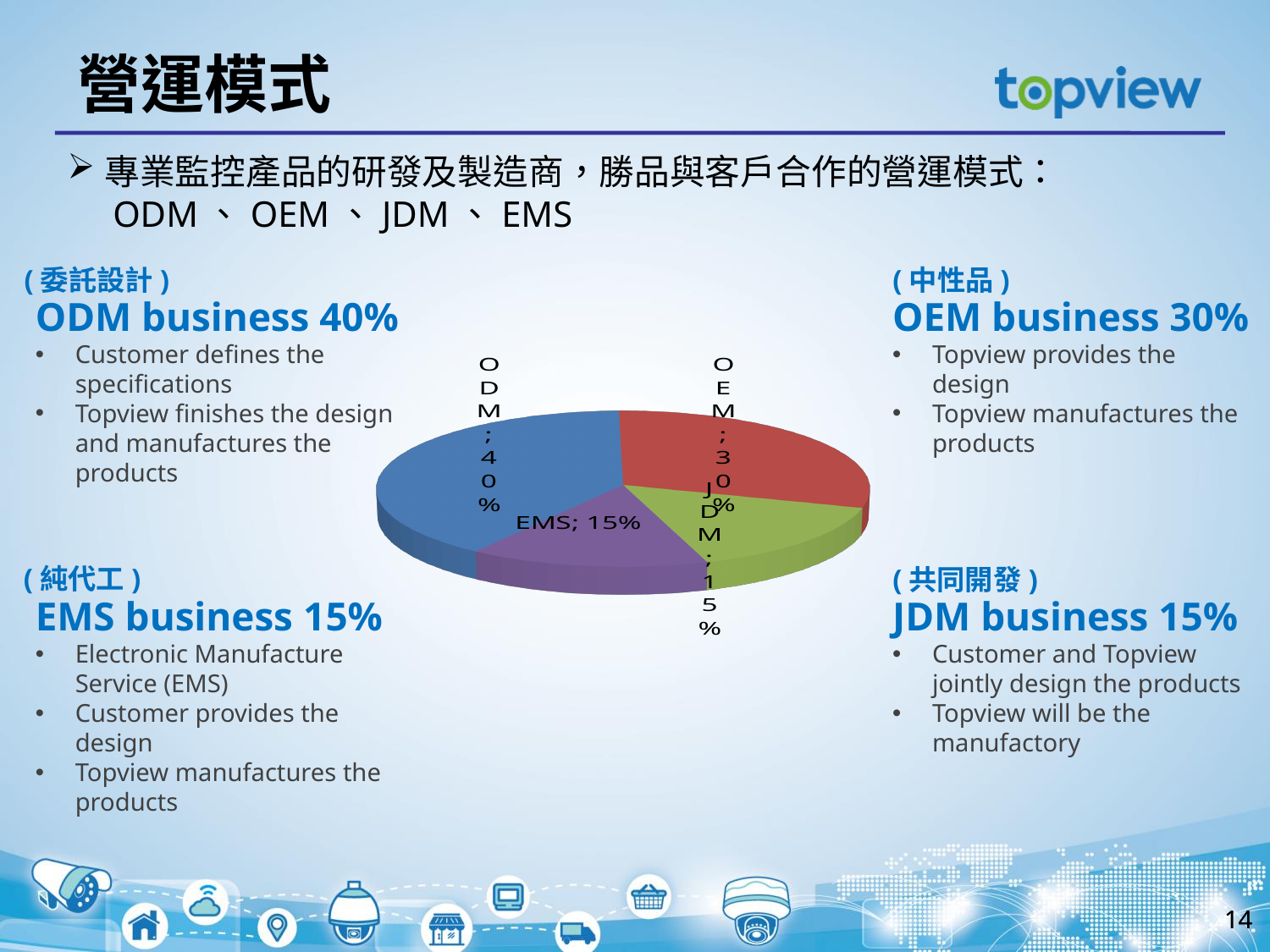
Which business model has the largest slice of the pie chart? ODM What kind of chart is shown on the slide? pie chart What colour is the ODM slice in the pie chart? blue What is the value shown for JDM in the pie chart? 15% How many slices does the pie chart have? 4 Which is larger in the pie chart, ODM or OEM? ODM Which is larger in the pie chart, OEM or JDM? OEM What is the difference between the ODM share and the OEM share? 10% What is the value shown for OEM in the pie chart? 30% What is the value shown for EMS in the pie chart? 15% What is the difference between the OEM share and the EMS share? 15% What share of the pie does ODM account for? 40%